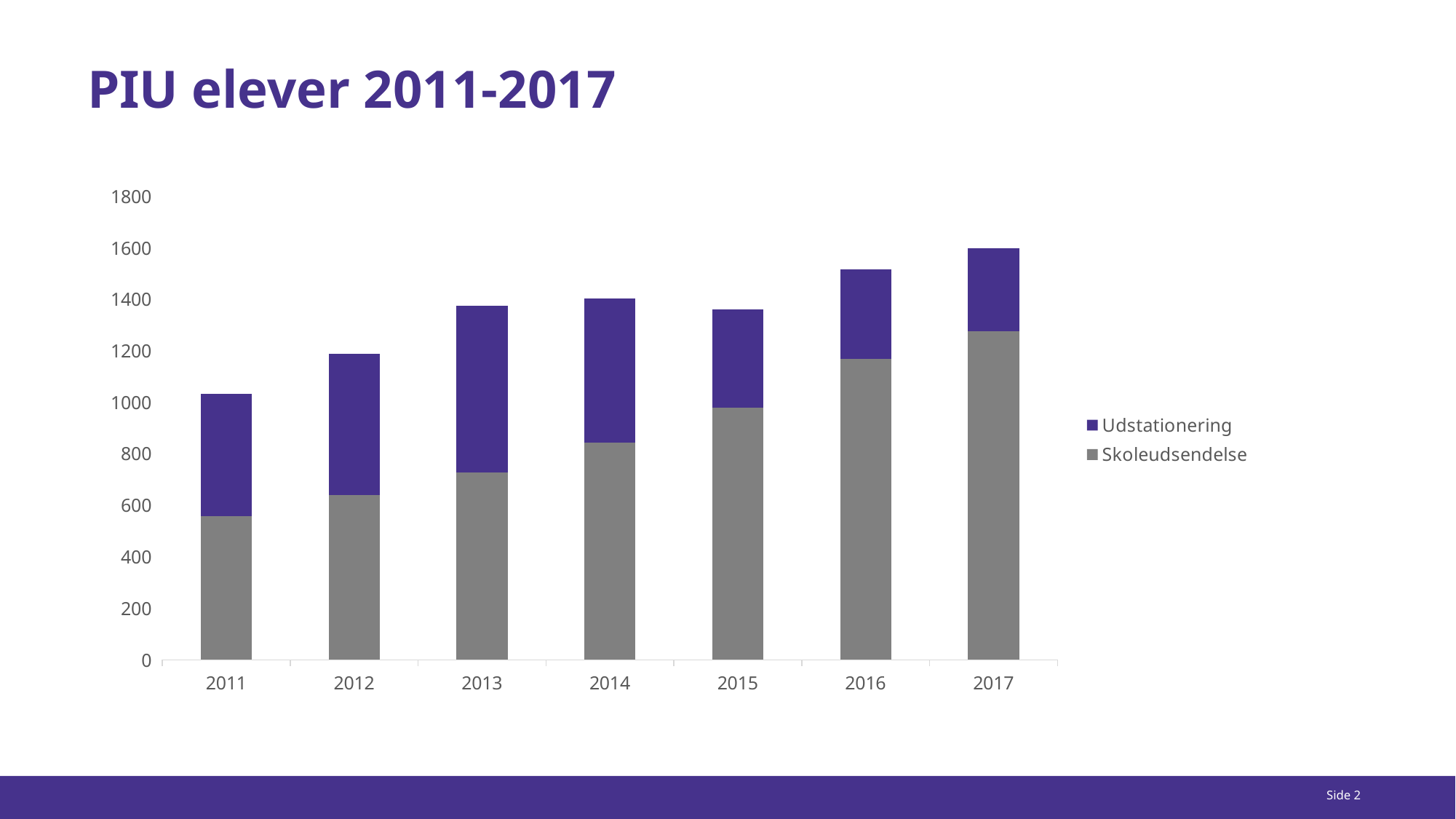
Is the total value for 2011 greater or less than 1000? greater Which year has the larger total bar, 2012 or 2015? 2015 How many years are shown on the x axis of the chart? 7 What is the title of the chart on the slide? PIU elever 2011-2017 What kind of chart is shown on the slide? Stacked bar chart Is the Skoleudsendelse value for 2017 greater or less than 1200? greater Is the Skoleudsendelse value for 2011 greater or less than 600? less Which year has the highest total bar in the chart? 2017 How many series does the legend list? 2 Does the Skoleudsendelse value rise or fall from 2011 to 2017? rise Which series is shown in purple in the chart? Udstationering Which year has the lowest total bar in the chart? 2011